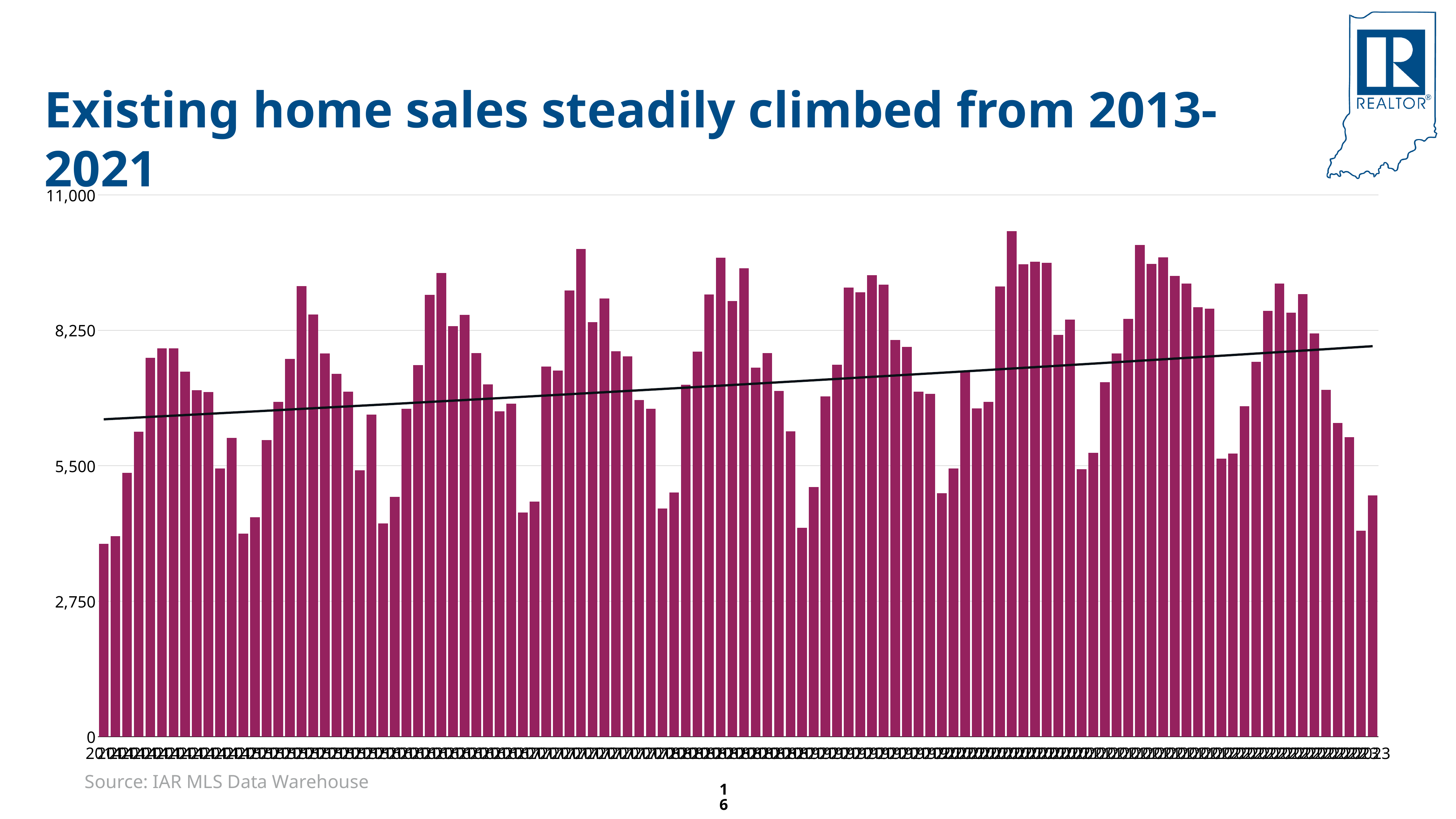
What is the source cited for the chart's data? IAR MLS Data Warehouse According to the trend line drawn across the bars, do existing home sales rise or fall over the period shown? rise Is the tallest bar in the chart greater or less than 8,250? greater Is the trend line at the left end of the chart greater or less than 5,500? greater Is the shortest bar in the chart greater or less than 5,500? less What kind of chart is shown on the slide? bar chart What is the title of the slide's chart? Existing home sales steadily climbed from 2013-2021 What is the highest value shown on the vertical axis of the chart? 11,000